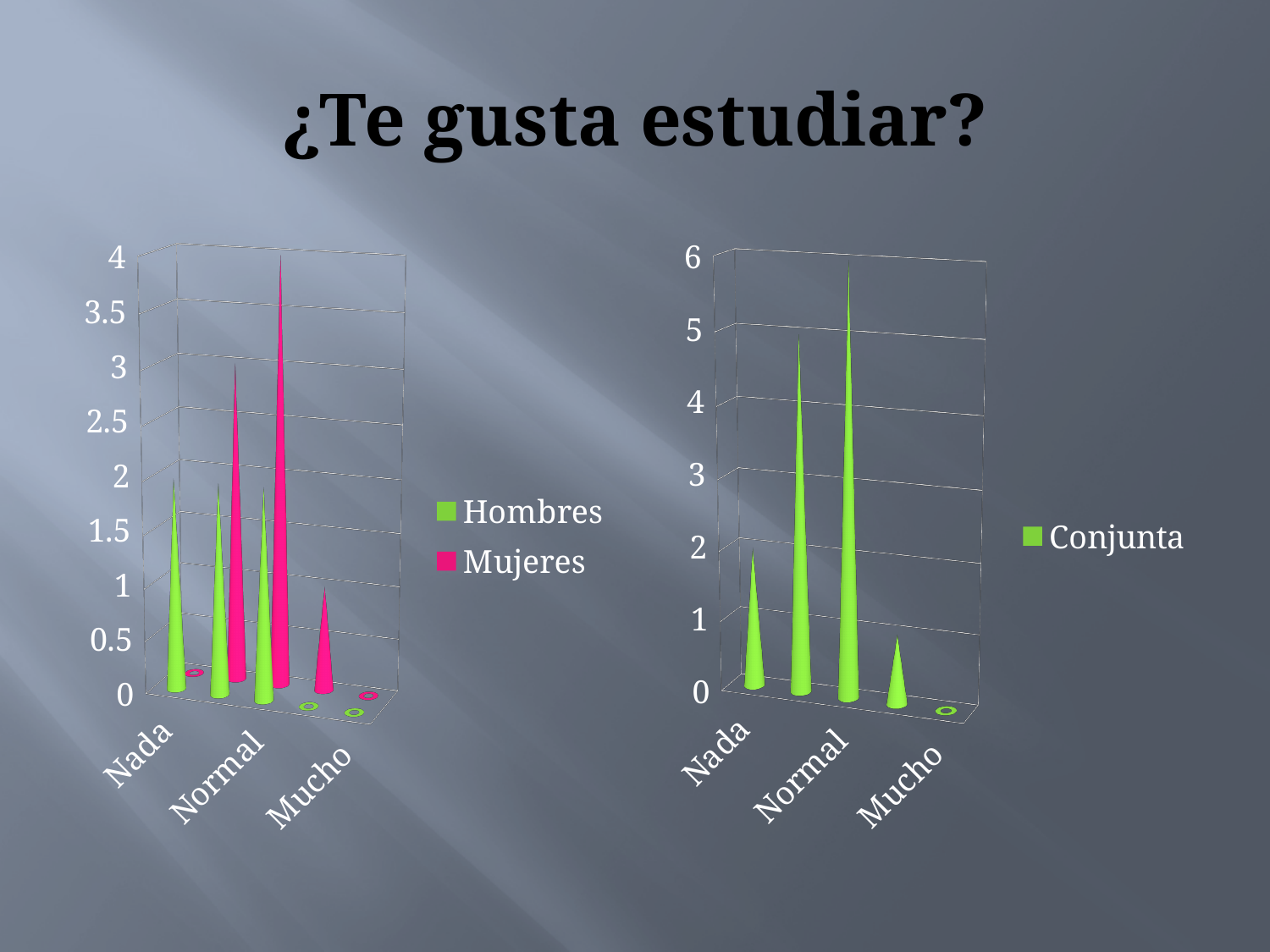
What is the highest value shown on the vertical axis of the left chart? 4 In the left chart, is the tallest Hombres value greater or less than 3? less In the right chart, is the tallest Conjunta value greater or less than 5? greater What is the highest value shown on the vertical axis of the right chart? 6 What is the name of the series in the right chart's legend? Conjunta How many series does the legend of the right chart list? 1 In the left chart, which series reaches the higher maximum value, Hombres or Mujeres? Mujeres What are the two series named in the legend of the left chart? Hombres and Mujeres What question is the slide title asking? ¿Te gusta estudiar? How many series does the legend of the left chart list? 2 What kind of chart is the left chart on the slide? bar chart In the left chart, is the tallest Mujeres value greater or less than 3? greater